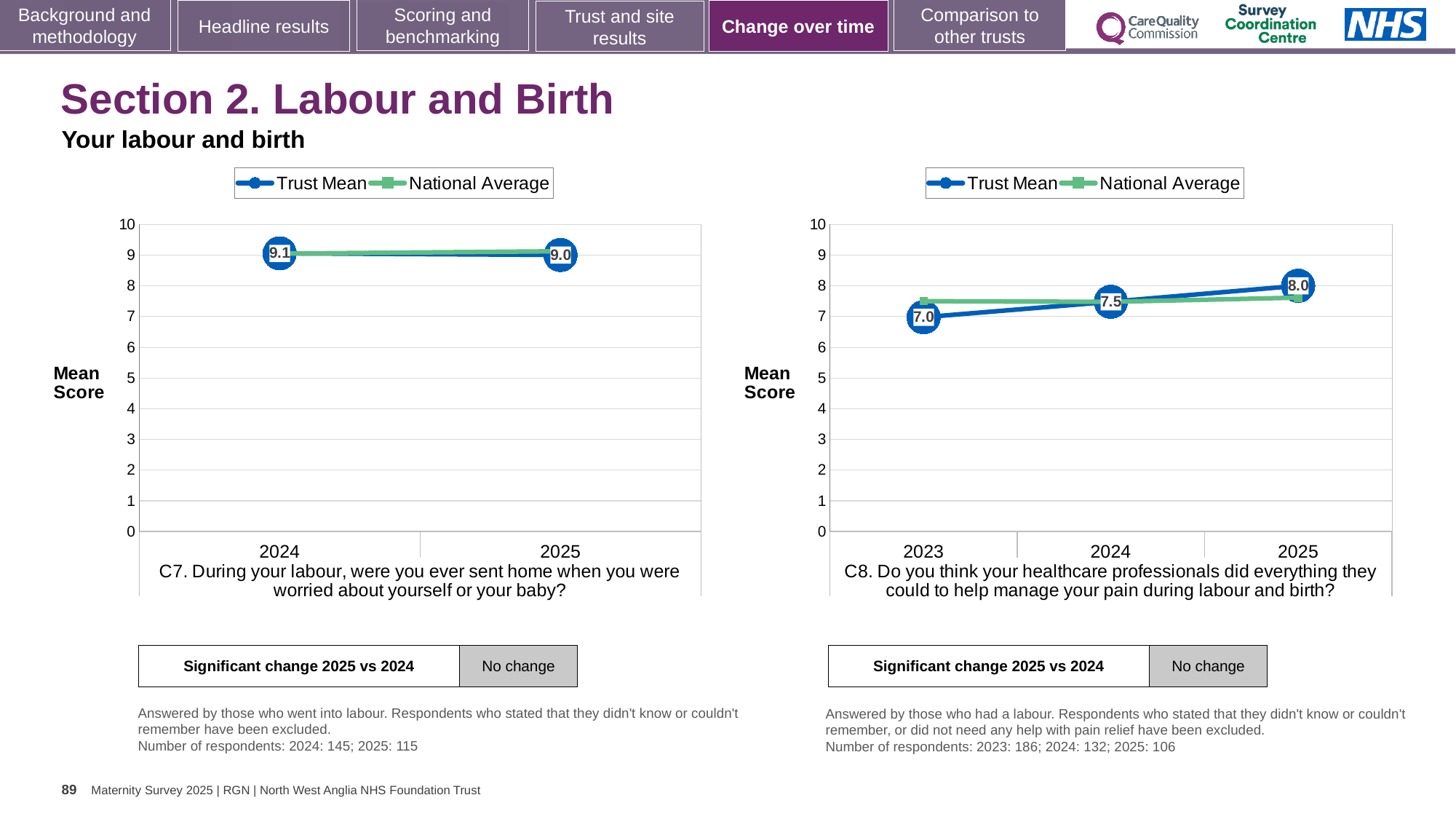
On the C8 chart (right), which year has the lowest Trust Mean? 2023 What type of chart is the C7 chart (left)? line chart On the C8 chart (right), what is the Trust Mean for 2023? 7.0 On the C8 chart (right), what is the difference between the Trust Mean for 2025 and 2023? 1.0 On the C7 chart (left), what is the Trust Mean for 2024? 9.1 On the C8 chart (right), which year has the highest Trust Mean? 2025 On the C8 chart (right), what is the Trust Mean for 2025? 8.0 On the C8 chart (right), does the Trust Mean rise or fall from 2023 to 2025? rise On the C7 chart (left), how many years are shown on the x axis? 2 On the C8 chart (right), how many series does the legend list? 2 On the C7 chart (left), what is the difference between the Trust Mean for 2024 and 2025? 0.1 On the C7 chart (left), what is the Trust Mean for 2025? 9.0